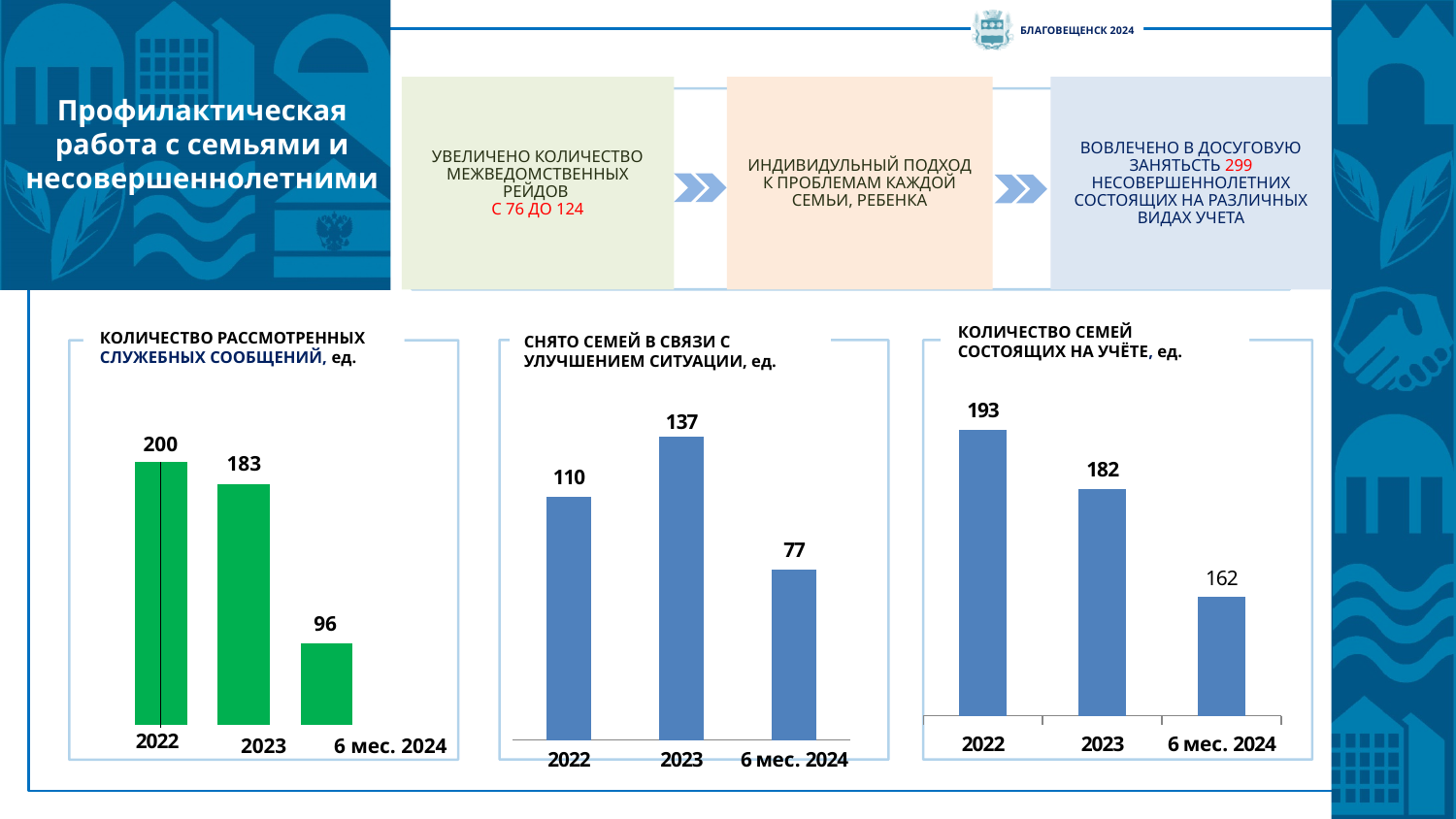
In the chart 'КОЛИЧЕСТВО СЕМЕЙ СОСТОЯЩИХ НА УЧЁТЕ, ед.', do the values rise or fall from 2022 to 6 мес. 2024? fall In the chart 'КОЛИЧЕСТВО СЕМЕЙ СОСТОЯЩИХ НА УЧЁТЕ, ед.', which is larger: the value for 2022 or for 2023? 2022 In the chart 'СНЯТО СЕМЕЙ В СВЯЗИ С УЛУЧШЕНИЕМ СИТУАЦИИ, ед.', which category has the highest value? 2023 In the chart 'СНЯТО СЕМЕЙ В СВЯЗИ С УЛУЧШЕНИЕМ СИТУАЦИИ, ед.', what is the value for 2022? 110 In the chart 'КОЛИЧЕСТВО СЕМЕЙ СОСТОЯЩИХ НА УЧЁТЕ, ед.', what is the value for 6 мес. 2024? 162 What type of chart is 'СНЯТО СЕМЕЙ В СВЯЗИ С УЛУЧШЕНИЕМ СИТУАЦИИ, ед.'? bar chart How many categories are shown in the chart 'КОЛИЧЕСТВО СЕМЕЙ СОСТОЯЩИХ НА УЧЁТЕ, ед.'? 3 In the chart 'СНЯТО СЕМЕЙ В СВЯЗИ С УЛУЧШЕНИЕМ СИТУАЦИИ, ед.', what is the difference between the 2023 and 6 мес. 2024 values? 60 In the chart 'КОЛИЧЕСТВО РАССМОТРЕННЫХ СЛУЖЕБНЫХ СООБЩЕНИЙ, ед.', what is the value for 2023? 183 In the chart 'КОЛИЧЕСТВО РАССМОТРЕННЫХ СЛУЖЕБНЫХ СООБЩЕНИЙ, ед.', which category has the lowest value? 6 мес. 2024 What colour are the bars in the chart 'КОЛИЧЕСТВО РАССМОТРЕННЫХ СЛУЖЕБНЫХ СООБЩЕНИЙ, ед.'? green In the chart 'КОЛИЧЕСТВО РАССМОТРЕННЫХ СЛУЖЕБНЫХ СООБЩЕНИЙ, ед.', what is the difference between the 2022 and 2023 values? 17